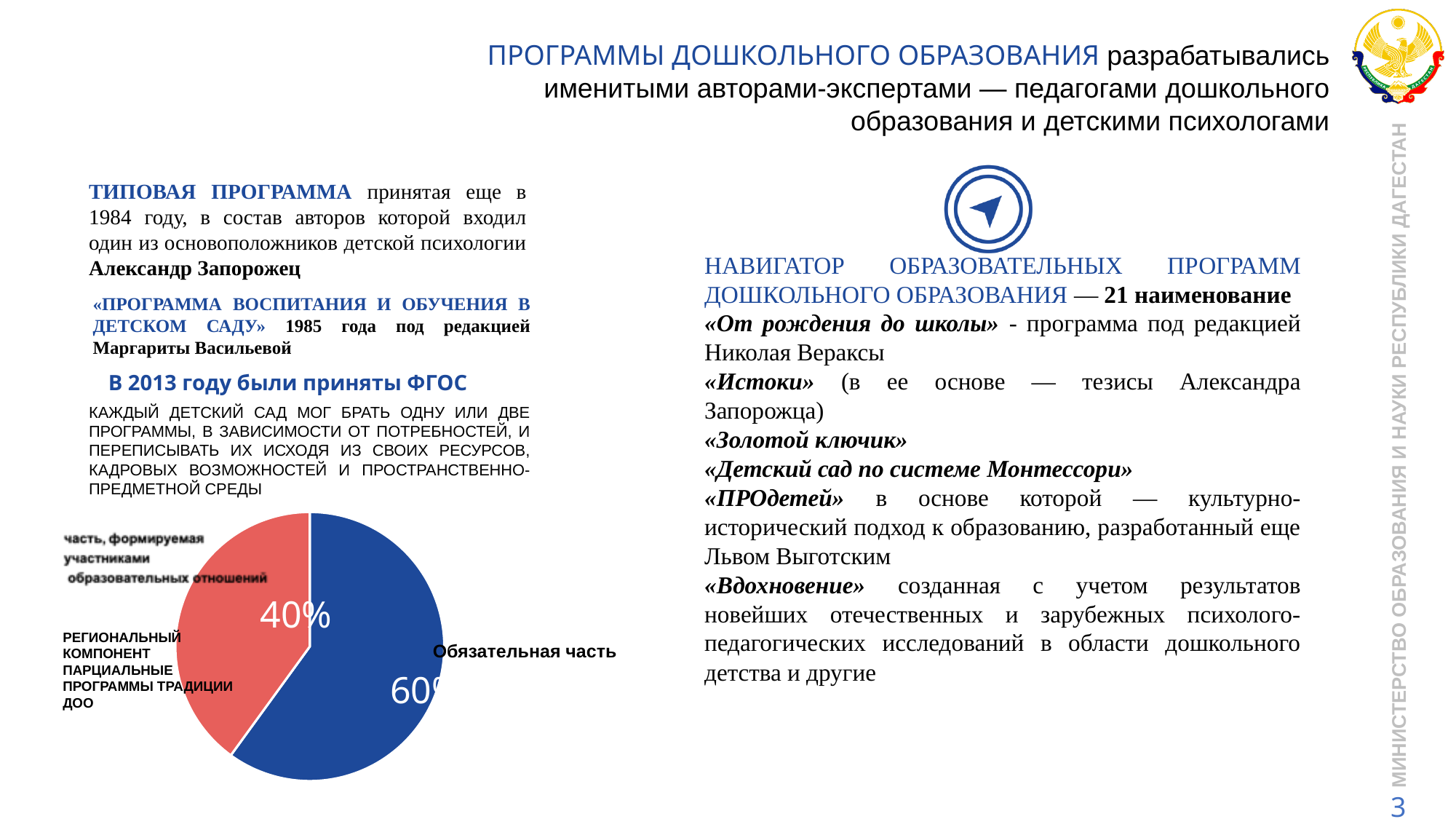
Which slice of the pie chart is the largest? Обязательная часть How many slices does the pie chart have? 2 What percentage does the pie chart show for «часть, формируемая участниками образовательных отношений»? 40% What colour is the «Обязательная часть» slice in the pie chart? blue What kind of chart is shown on the slide? pie chart What percentage does the pie chart show for «Обязательная часть»? 60% Which is larger in the pie chart: «Обязательная часть» or «часть, формируемая участниками образовательных отношений»? Обязательная часть What share of the pie does «Обязательная часть» take? 60% Which slice of the pie chart is the smallest? часть, формируемая участниками образовательных отношений What colour is the 40% slice in the pie chart? red By how many percentage points does «Обязательная часть» exceed «часть, формируемая участниками образовательных отношений» in the pie chart? 20